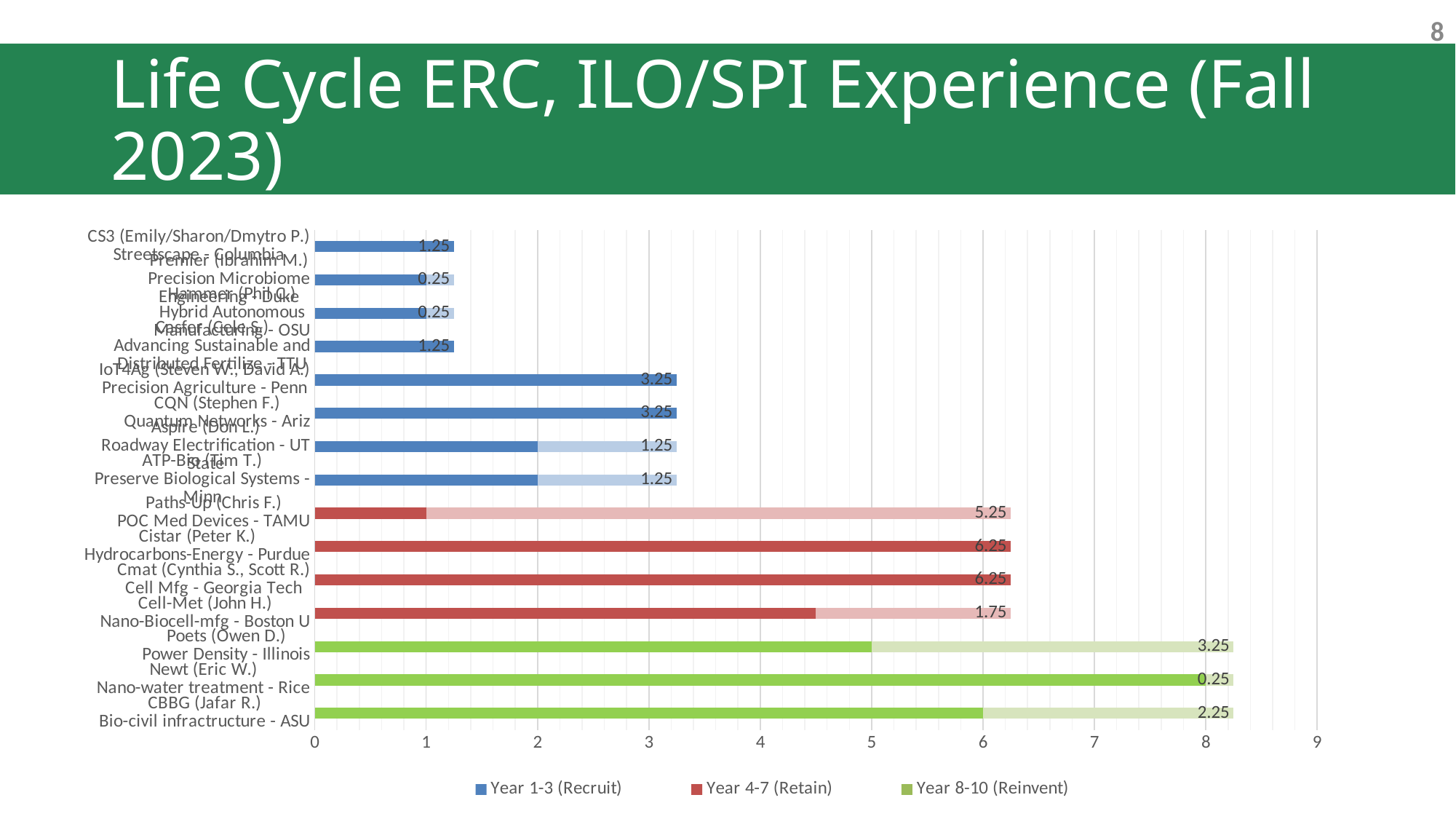
What data label is shown on the bar for Poets (Owen D.) Power Density - Illinois? 3.25 Which has the larger data label: Paths-Up (Chris F.) POC Med Devices - TAMU or Cell-Met (John H.) Nano-Biocell-mfg - Boston U? Paths-Up (Chris F.) POC Med Devices - TAMU How many series does the legend list? 3 What data label is shown on the bar for Cistar (Peter K.) Hydrocarbons-Energy - Purdue? 6.25 What data label is shown on the bar for CBBG (Jafar R.) Bio-civil infracture - ASU? 2.25 What data label is shown on the bar for Cell-Met (John H.) Nano-Biocell-mfg - Boston U? 1.75 What is the difference between the data labels for Paths-Up (Chris F.) POC Med Devices - TAMU and Cell-Met (John H.) Nano-Biocell-mfg - Boston U? 3.5 What data label is shown on the bar for Paths-Up (Chris F.) POC Med Devices - TAMU? 5.25 What data label is shown on the bar for Newt (Eric W.) Nano-water treatment - Rice? 0.25 What are the three series named in the legend? Year 1-3 (Recruit), Year 4-7 (Retain), Year 8-10 (Reinvent) What kind of chart is shown on the slide? bar chart What colour represents the Year 8-10 (Reinvent) series? green